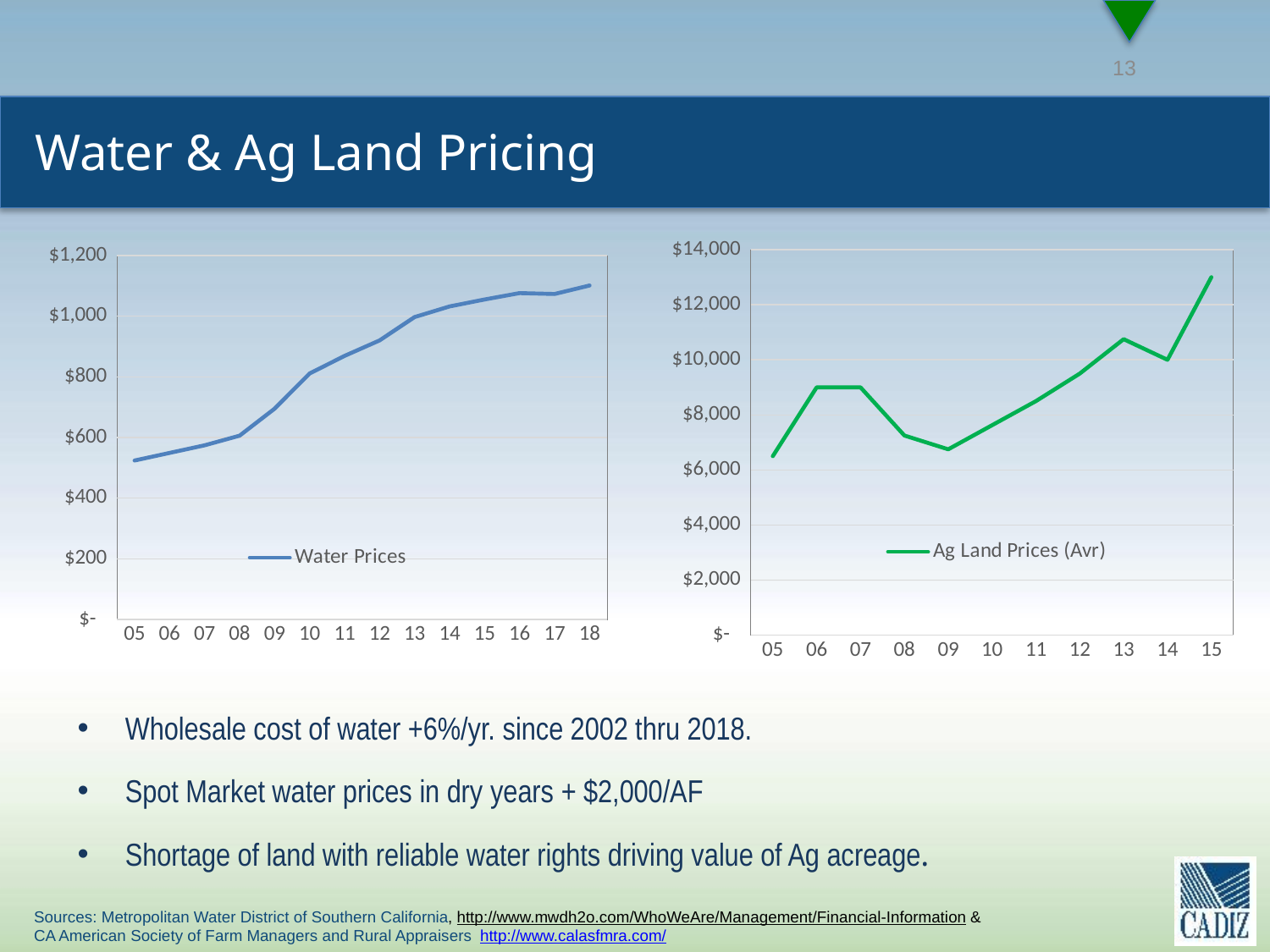
In the right chart (Ag Land Prices (Avr)), which is higher, the value for 13 or the value for 14? 13 In the right chart (Ag Land Prices (Avr)), is the value for 09 greater or less than $8,000? less In the left chart (Water Prices), how many years are shown on the x axis? 14 In the left chart (Water Prices), is the value for 18 greater or less than $1,000? greater In the left chart (Water Prices), is the value for 05 greater or less than $600? less In the right chart (Ag Land Prices (Avr)), which year has the highest value? 15 How many series does the legend of the right chart list? 1 In the left chart (Water Prices), which year has the lowest value? 05 What type of chart is the left chart titled 'Water Prices'? line chart In the left chart (Water Prices), which year has the highest value? 18 In the right chart (Ag Land Prices (Avr)), how many years are shown on the x axis? 11